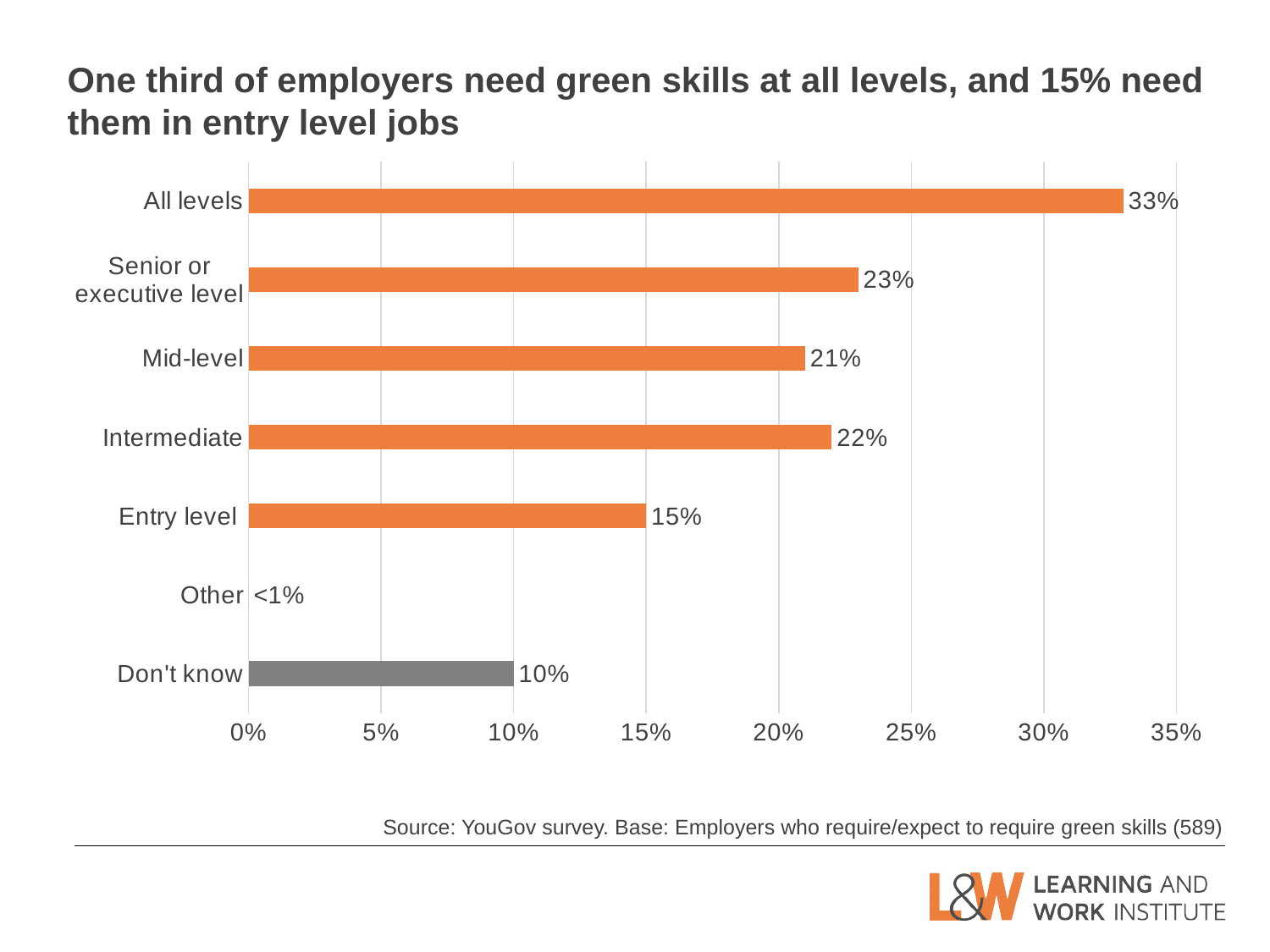
Which category has the lowest value? Other What is the value for Entry level? 15% What is the value for Don't know? 10% What is the value for Senior or executive level? 23% Which is larger, the value for Mid-level or the value for Intermediate? Intermediate What is the value for All levels? 33% What is the value shown for Other? <1% How many categories are shown on the chart? 7 What is the difference between the values for All levels and Entry level? 18% What kind of chart is shown on the slide? Bar chart Which category has the highest value? All levels Which bar is coloured grey rather than orange? Don't know